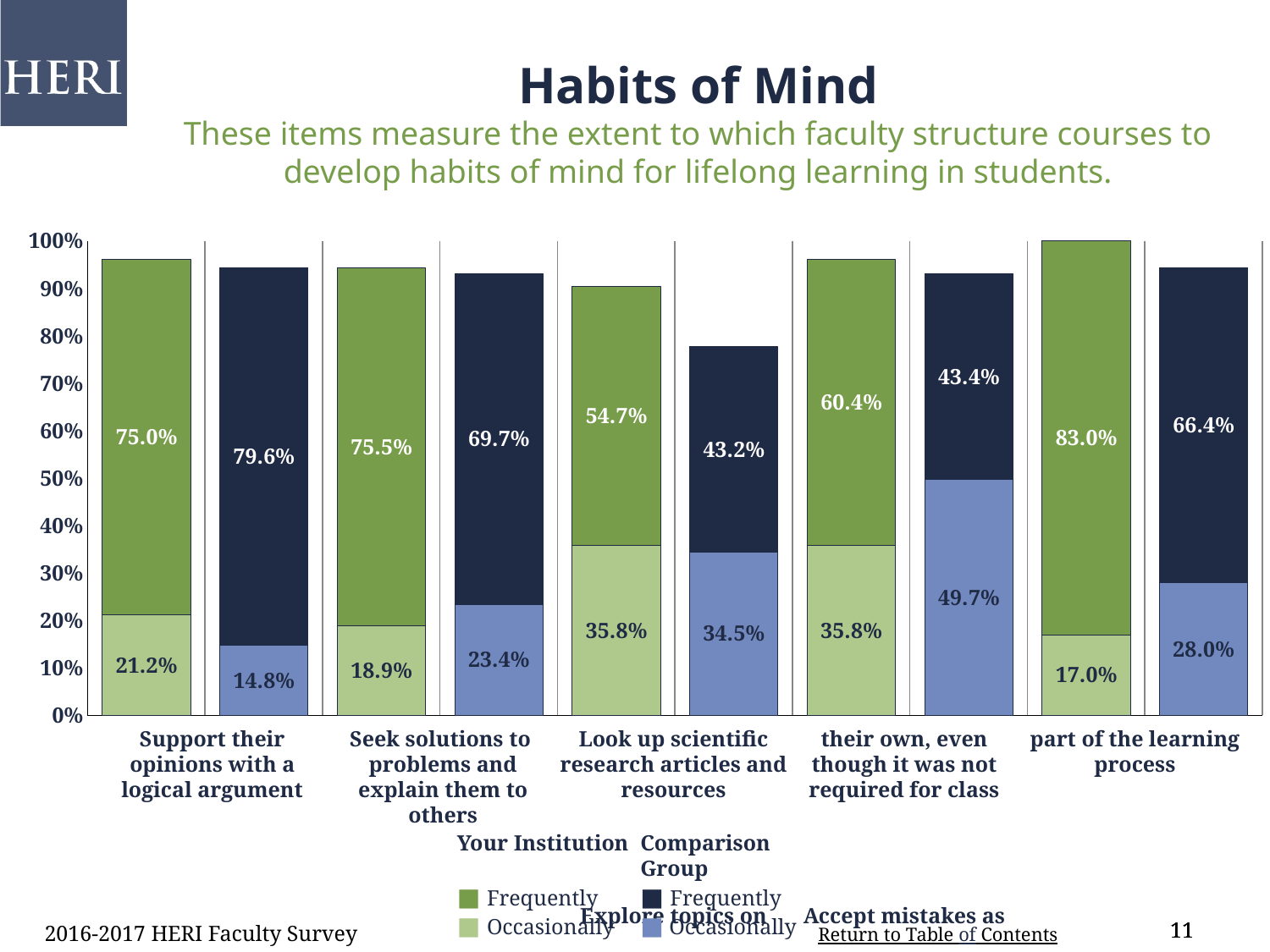
What is the total of the Your Institution stacked bar (Frequently plus Occasionally) for 'Look up scientific research articles and resources'? 90.5% Which item has the lowest Comparison Group 'Frequently' percentage? Look up scientific research articles and resources What percentage of Your Institution faculty report 'Frequently' for 'Support their opinions with a logical argument'? 75.0% How many items (categories) are shown along the x axis? 5 What is the Your Institution 'Frequently' value for 'Look up scientific research articles and resources'? 54.7% What is the Comparison Group 'Occasionally' value for 'Seek solutions to problems and explain them to others'? 23.4% What is the difference between the Your Institution and Comparison Group 'Frequently' values for 'Accept mistakes as part of the learning process'? 16.6% Which item has the highest Your Institution 'Frequently' percentage? Accept mistakes as part of the learning process For 'Support their opinions with a logical argument', which is larger: the Your Institution 'Frequently' value or the Comparison Group 'Frequently' value? Comparison Group (79.6%) What is the total of the Comparison Group stacked bar for 'Accept mistakes as part of the learning process'? 94.4% What kind of chart is shown on the slide? Stacked bar chart How many entries does the legend list? 4